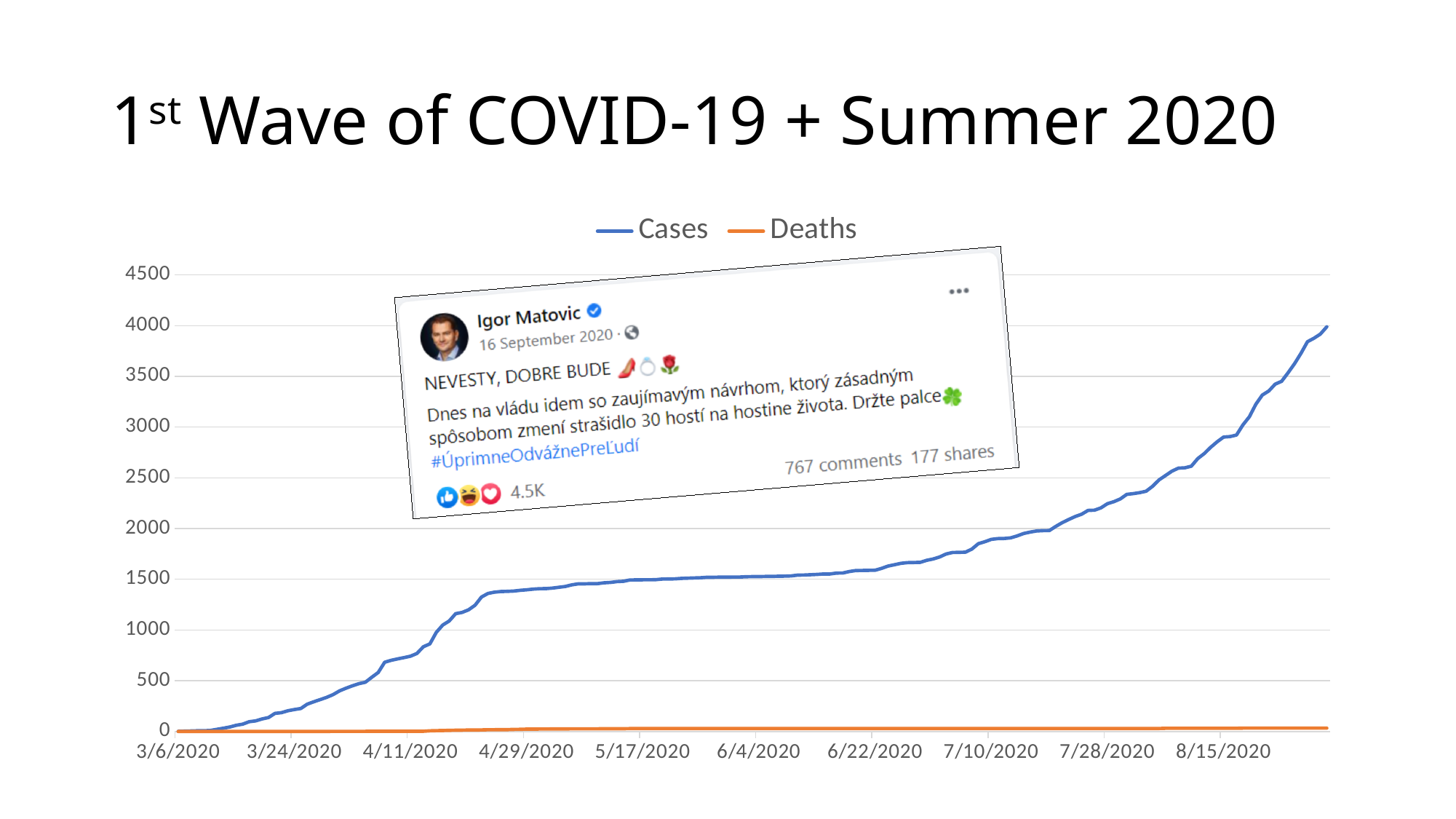
Is the value for Cases at 4/29/2020 greater or less than 1000? greater Is the value for Cases at 7/10/2020 greater or less than 2000? less Do the Cases values rise or fall along the x axis from 3/6/2020 onward? rise Which series has the higher values throughout the chart, Cases or Deaths? Cases Is the value for Deaths at 8/15/2020 greater or less than 500? less How many series does the chart legend list? 2 What kind of chart is shown on the slide? line chart What are the two series named in the chart legend? Cases and Deaths At 7/28/2020, which series has the larger value, Cases or Deaths? Cases Which series is drawn in blue? Cases